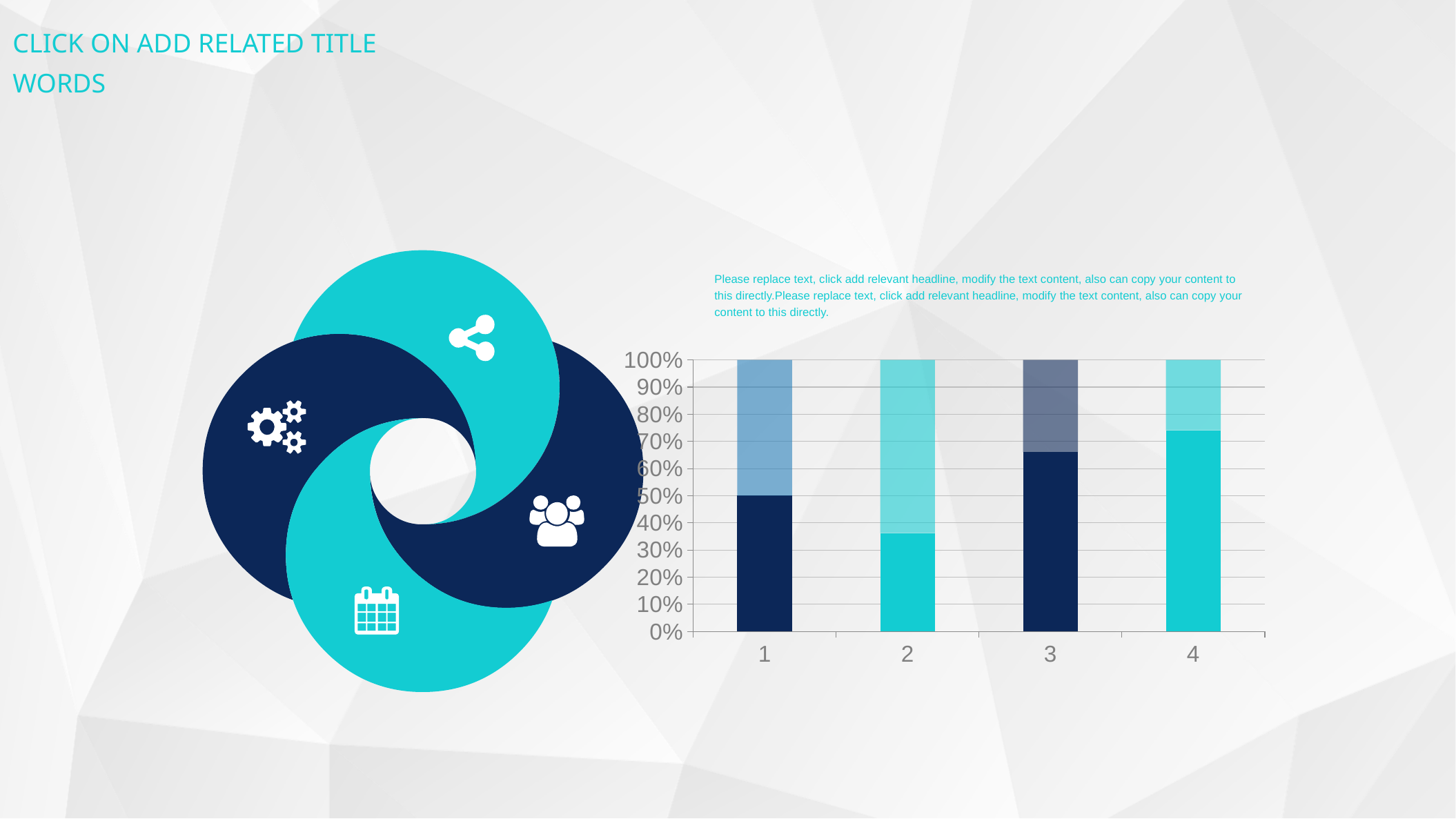
What is the total height of the stacked bar for category 4? 100% How many categories are shown on the x axis of the chart? 4 Is the bottom segment of the bar for category 3 greater or less than 60%? greater What is the highest value shown on the y axis of the chart? 100% Which category has the shortest bottom segment? 2 Is the bottom segment of the bar for category 4 greater or less than 70%? greater Is the bottom segment of the bar for category 1 greater or less than 40%? greater What kind of chart is shown on the slide? stacked bar chart Which category has the larger bottom segment, category 1 or category 3? 3 Which category has the tallest bottom segment? 4 What is the total height of the stacked bar for category 1? 100%